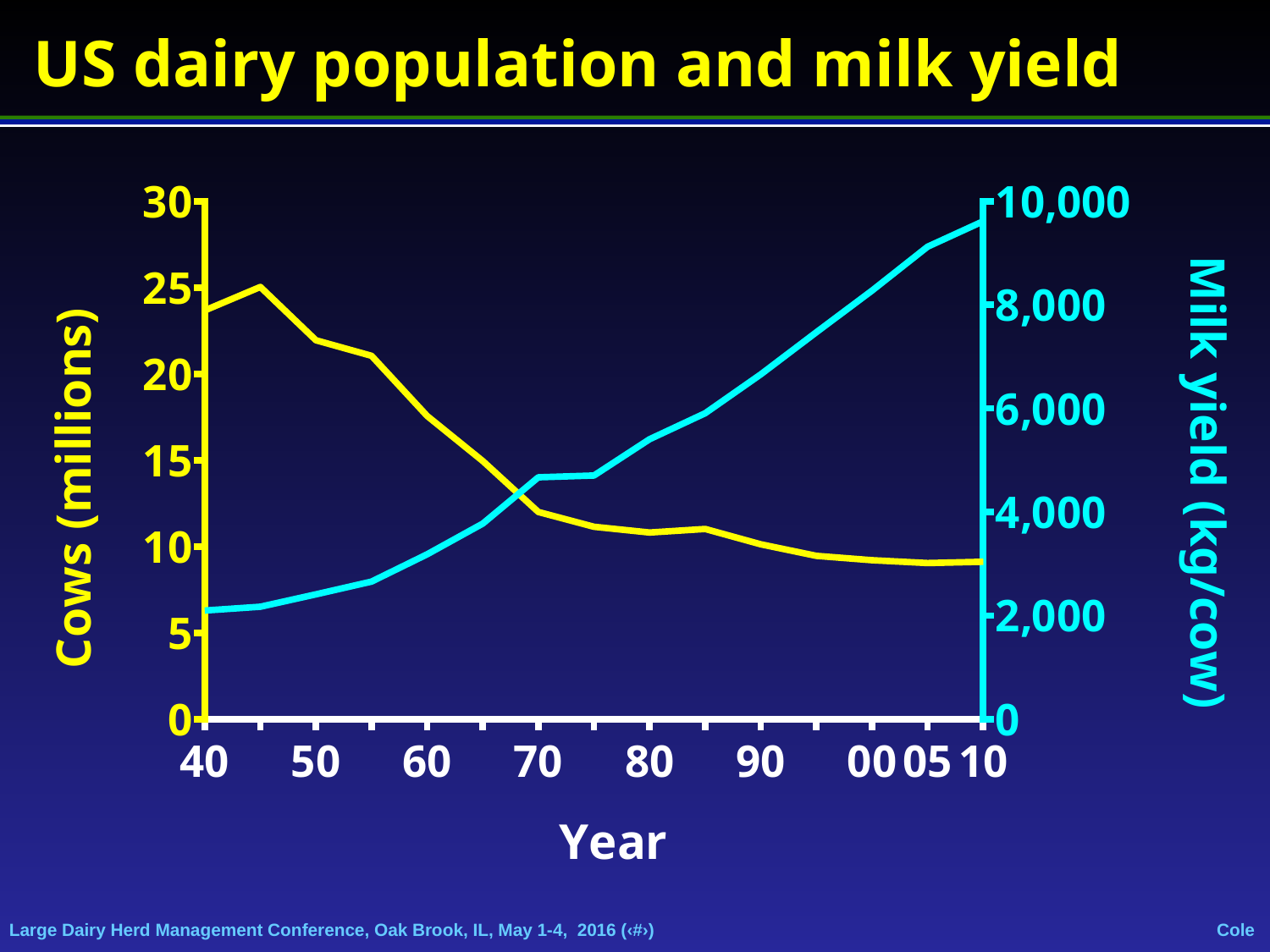
What does the right-hand vertical axis measure? Milk yield (kg/cow) How does the number of cows (yellow line) change from 1950 to 2010? It falls Is the milk yield (kg/cow) in 1990 greater or less than 6,000? greater Which year has the larger number of cows, 1940 or 1990? 1940 What is the title of the chart? US dairy population and milk yield In which labelled year is milk yield (kg/cow) highest? 10 Is the milk yield (kg/cow) in 1960 greater or less than 4,000? less Is the number of cows (millions) in 1940 greater or less than 20? greater How does milk yield (cyan line) change from 1940 to 2010? It rises What kind of chart is shown on the slide? line chart